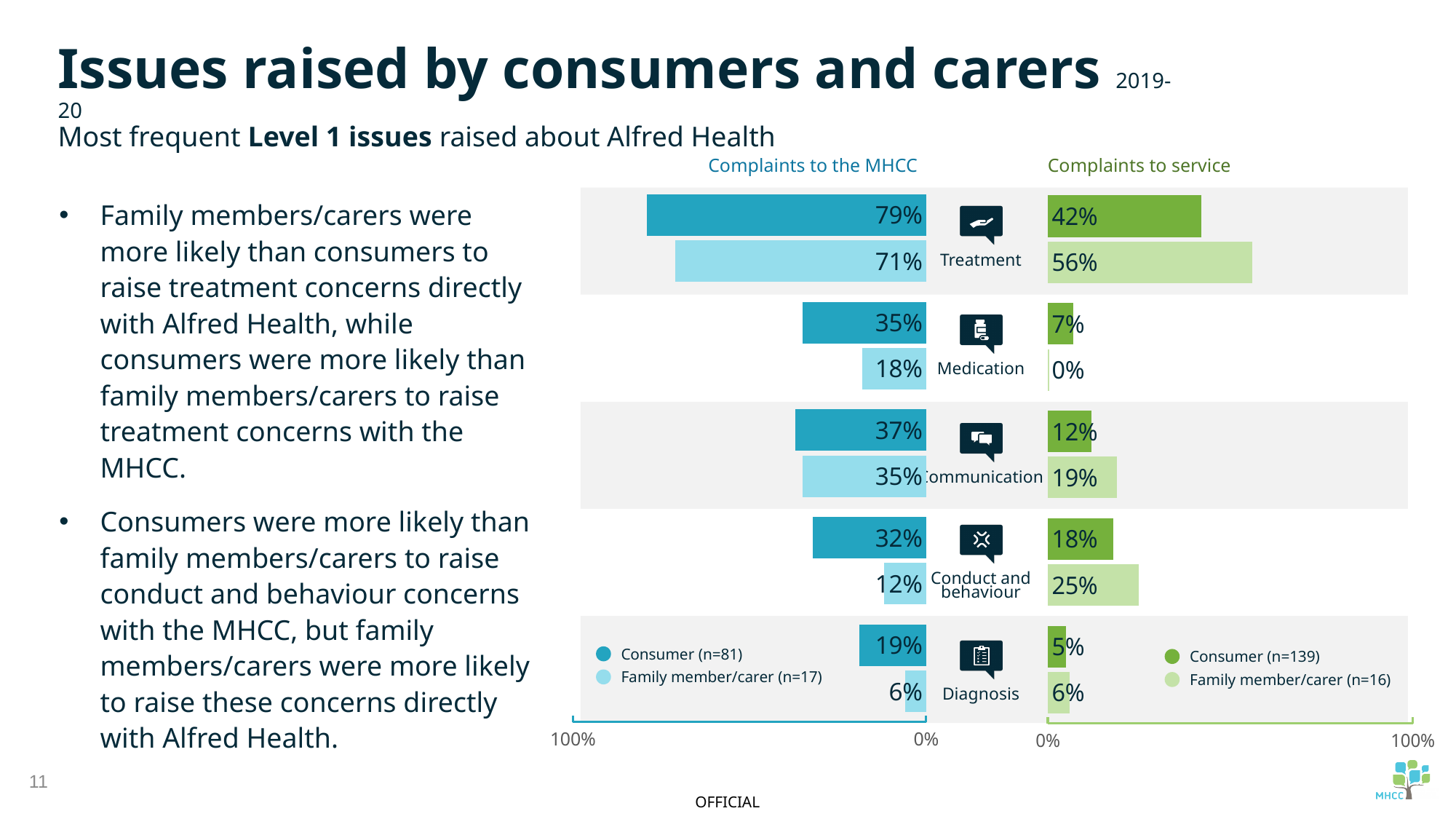
According to the legend of the 'Complaints to service' chart, what is the sample size (n) for consumers? 139 In the 'Complaints to service' chart, which issue has the lowest Consumer value? Diagnosis In the 'Complaints to service' chart, what percentage of family members/carers raised Treatment issues? 56% In the 'Complaints to the MHCC' chart, what percentage of consumers raised Treatment issues? 79% How many issue categories are shown in the 'Complaints to the MHCC' chart? 5 In the 'Complaints to the MHCC' chart, which issue has the highest Consumer value? Treatment In the 'Complaints to the MHCC' chart, what is the Family member/carer value for Conduct and behaviour? 12% How many series does the legend of the 'Complaints to service' chart list? 2 What type of chart is the 'Complaints to the MHCC' chart? Bar chart In the 'Complaints to the MHCC' chart, what is the difference between the Consumer and Family member/carer values for Medication? 17% In the 'Complaints to service' chart, which is larger for Conduct and behaviour: the Consumer value or the Family member/carer value? Family member/carer In the 'Complaints to service' chart, what is the Family member/carer value for Medication? 0%